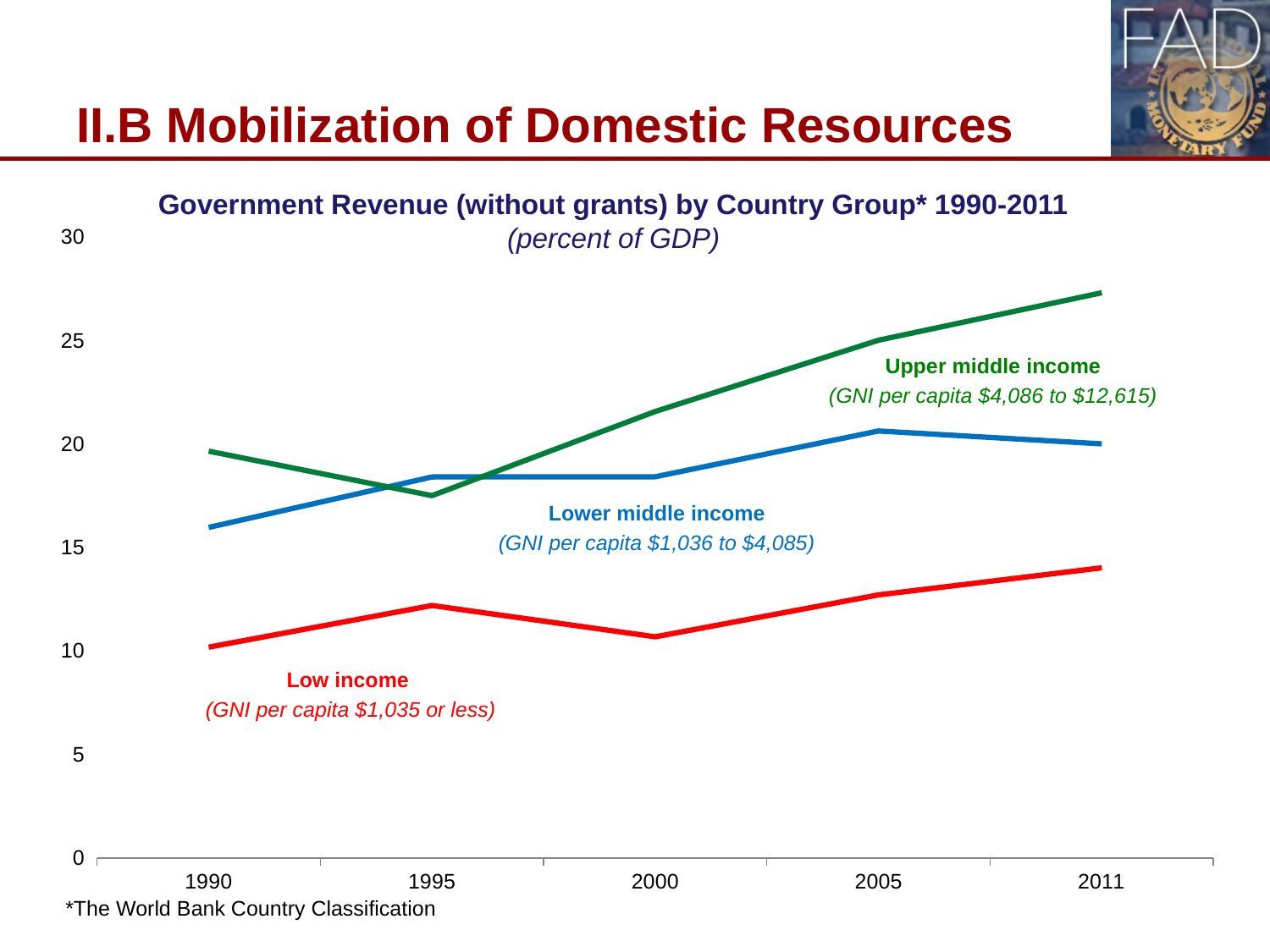
In 1990, which is larger: the value for Upper middle income or the value for Lower middle income? Upper middle income Is the value for Low income in 2011 greater or less than 15? less What kind of chart is shown on the slide? Line chart How many country groups (series) are plotted in the chart? 3 What is the unit of measurement given in the chart subtitle? percent of GDP Is the value for Upper middle income in 2011 greater or less than 25? greater How many years are labelled on the x axis of the chart? 5 Which country group has the lowest government revenue in 1990? Low income Is the value for Lower middle income in 1990 greater or less than 15? greater Which country group has the highest government revenue in 2011? Upper middle income Does the Upper middle income line rise or fall between 2000 and 2011? Rises